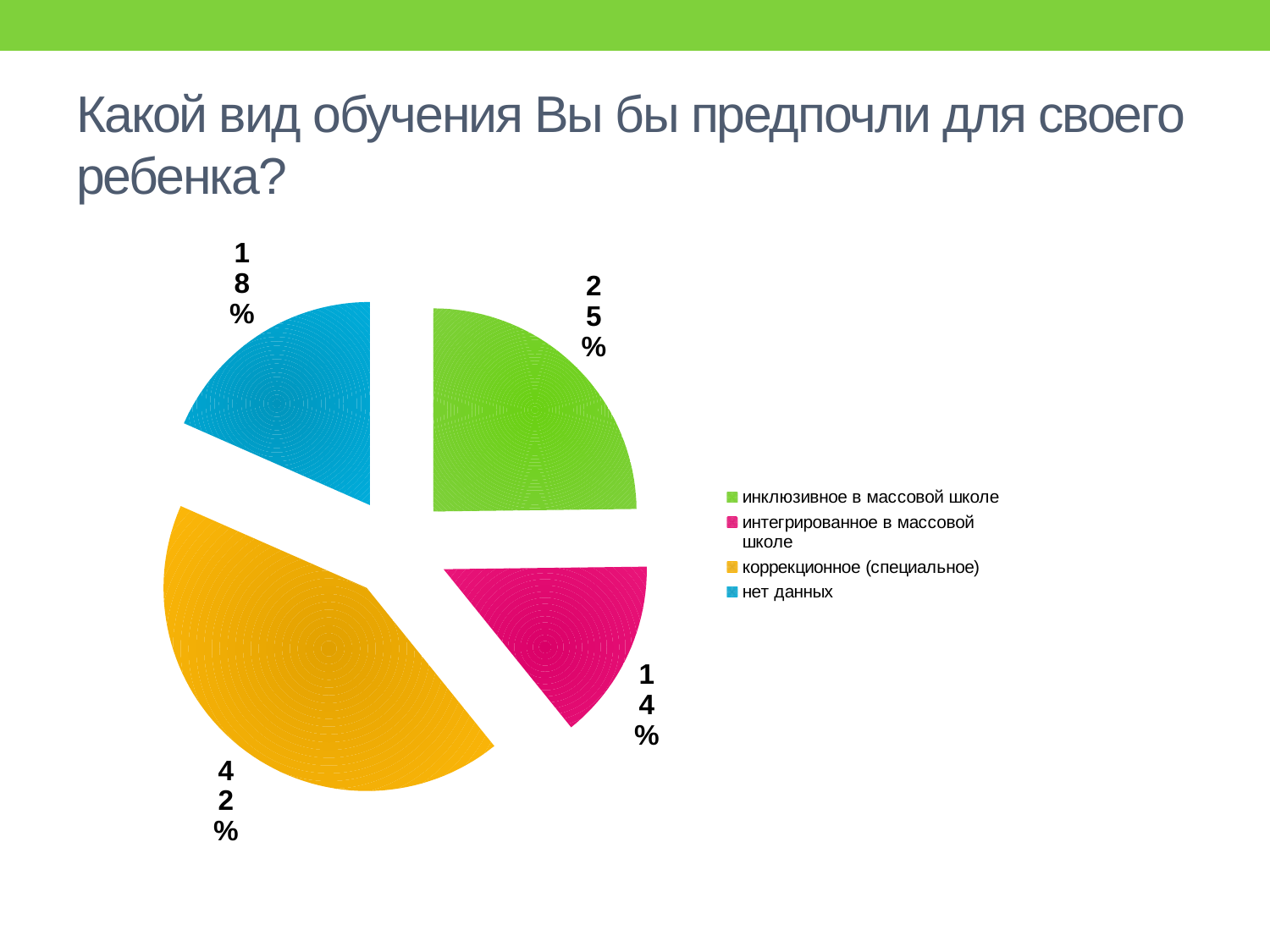
What is the title of the slide above the chart? Какой вид обучения Вы бы предпочли для своего ребенка? What share of the pie is labelled for "нет данных"? 18% What share of the pie is labelled for "инклюзивное в массовой школе"? 25% What share of the pie is labelled for "коррекционное (специальное)"? 42% What is the difference in percentage points between "коррекционное (специальное)" and "инклюзивное в массовой школе"? 17 Which category has the largest slice of the pie? коррекционное (специальное) Which category has the smallest slice of the pie? интегрированное в массовой школе What colour is the slice for "нет данных"? blue What kind of chart is shown on the slide? pie chart How many slices does the pie chart have? 4 Which is larger: the slice for "нет данных" or the slice for "интегрированное в массовой школе"? нет данных What share of the pie is labelled for "интегрированное в массовой школе"? 14%